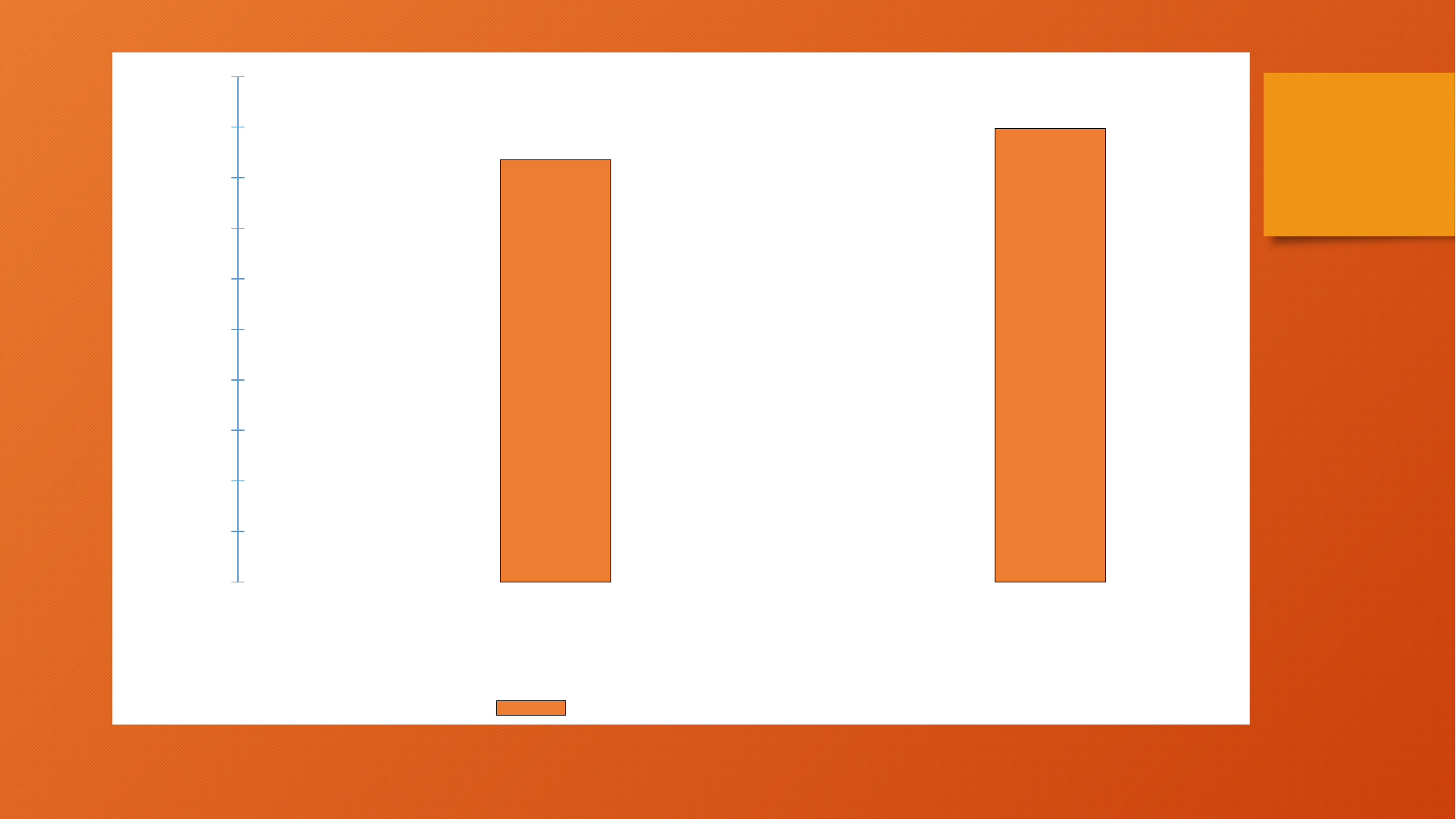
Which bar is the lowest in the chart? the left bar Are the bars in the chart vertical or horizontal? vertical What colour are the bars in the chart? orange Do the bar values rise or fall from left to right? rise How many bars are plotted in the chart? 2 Which bar is the highest in the chart? the right bar What kind of chart is shown on the slide? bar chart How many series does the legend show? 1 Which bar is taller, the left bar or the right bar? the right bar